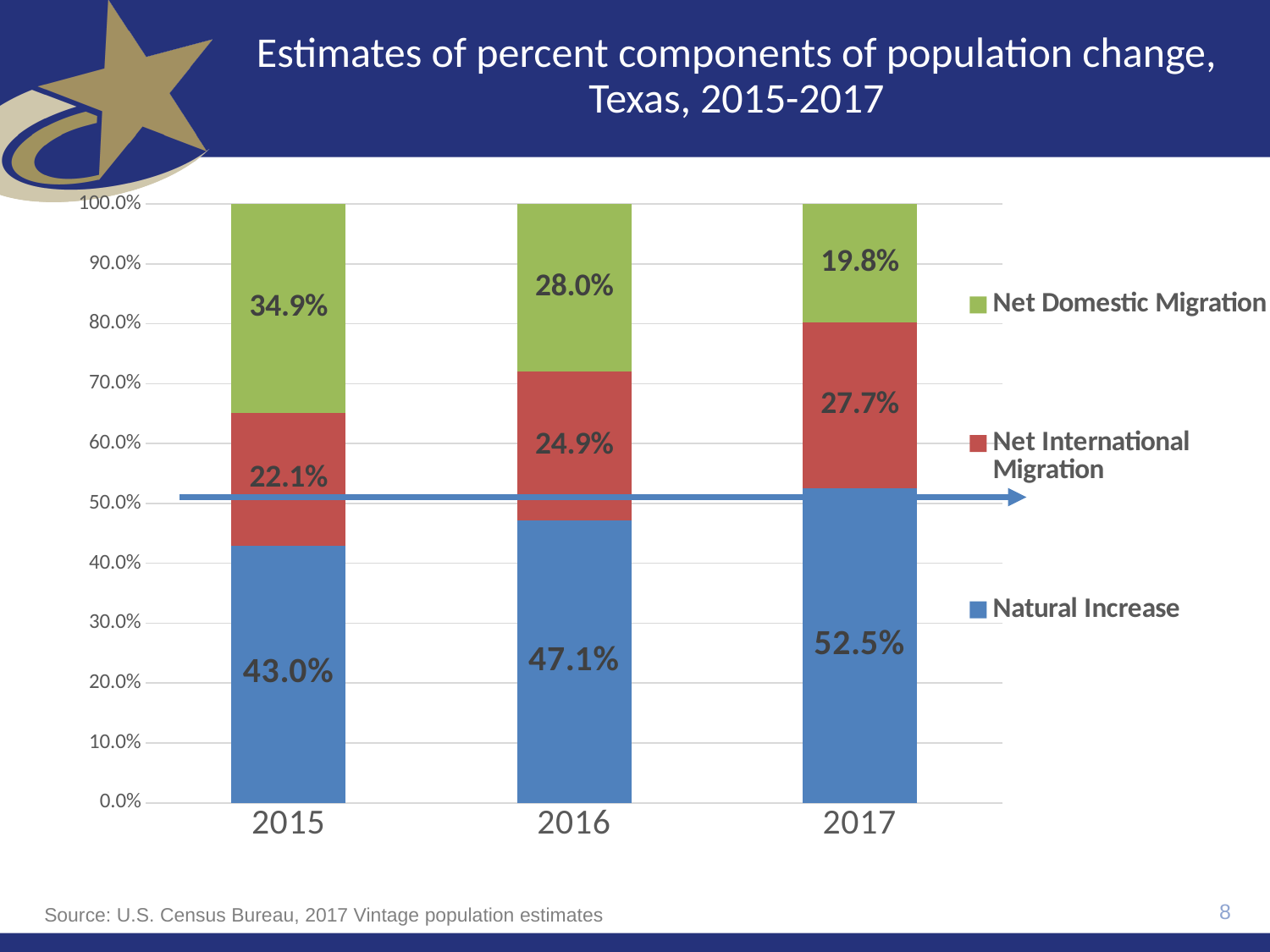
What is the Net International Migration value for 2016? 24.9% What kind of chart is shown on the slide? Stacked bar chart Which is larger in 2016: Net Domestic Migration or Net International Migration? Net Domestic Migration What is the Net Domestic Migration value for 2015? 34.9% Which year has the lowest Net Domestic Migration value? 2017 How many series does the legend list? 3 Which year has the highest Natural Increase value? 2017 How many years are shown on the x axis? 3 What is the Natural Increase value for 2017? 52.5% What is the difference between the Natural Increase values for 2017 and 2015? 9.5% What is the total of the stacked bar for 2016? 100.0% Does the Net Domestic Migration value rise or fall from 2015 to 2017? Fall